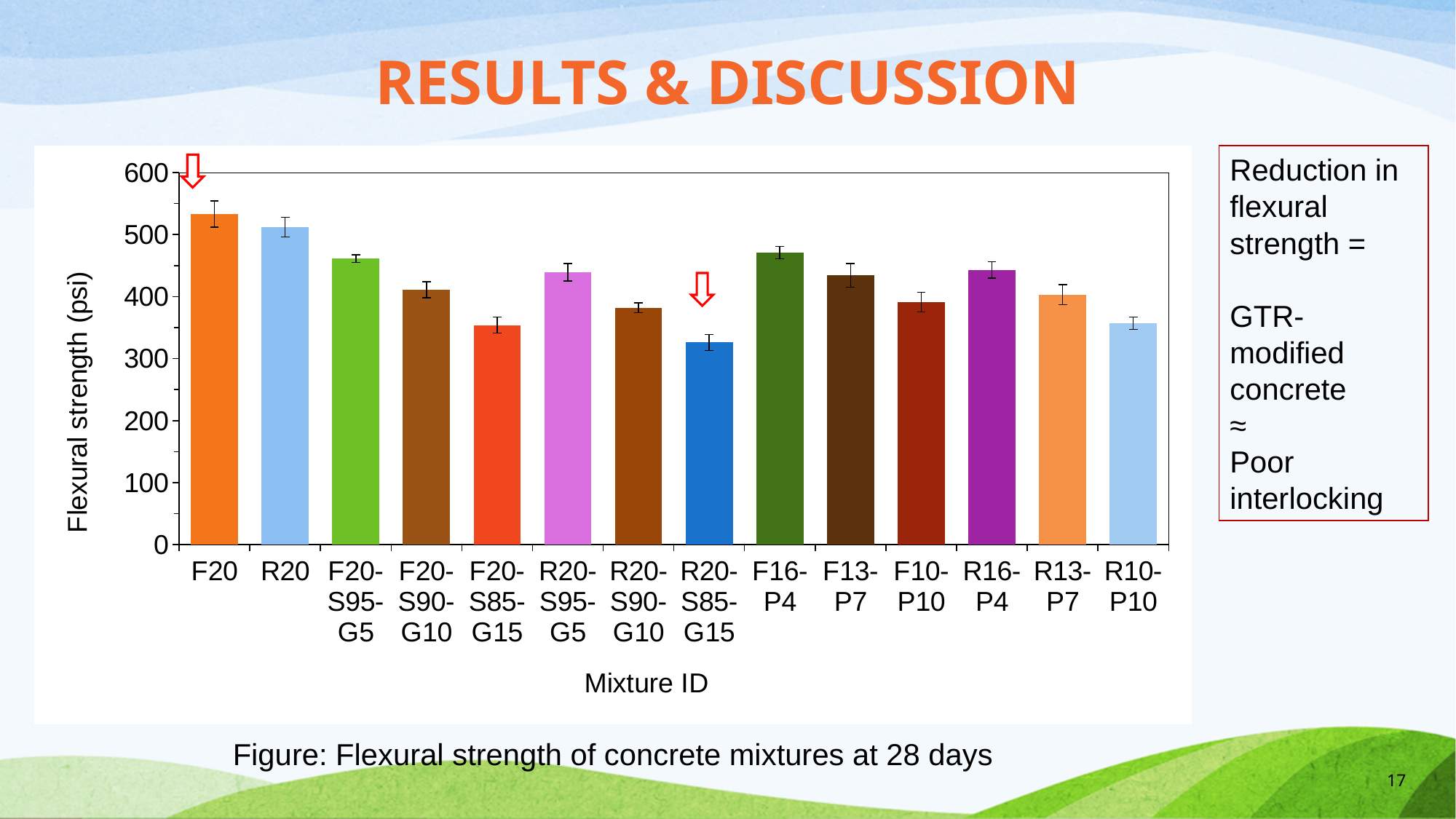
What is the label of the x axis? Mixture ID Is the flexural strength for F20 greater or less than 500 psi? greater Which mixture has the lowest flexural strength? R20-S85-G15 Is the flexural strength for R20-S85-G15 greater or less than 400 psi? less How many mixture IDs are plotted on the x axis? 14 Which has the higher flexural strength, F16-P4 or F13-P7? F16-P4 Is the flexural strength for F16-P4 greater or less than 400 psi? greater What is the label of the y axis? Flexural strength (psi) What kind of chart is shown on the slide? bar chart Which has the higher flexural strength, F20-S90-G10 or R20-S90-G10? F20-S90-G10 Which mixture has the highest flexural strength? F20